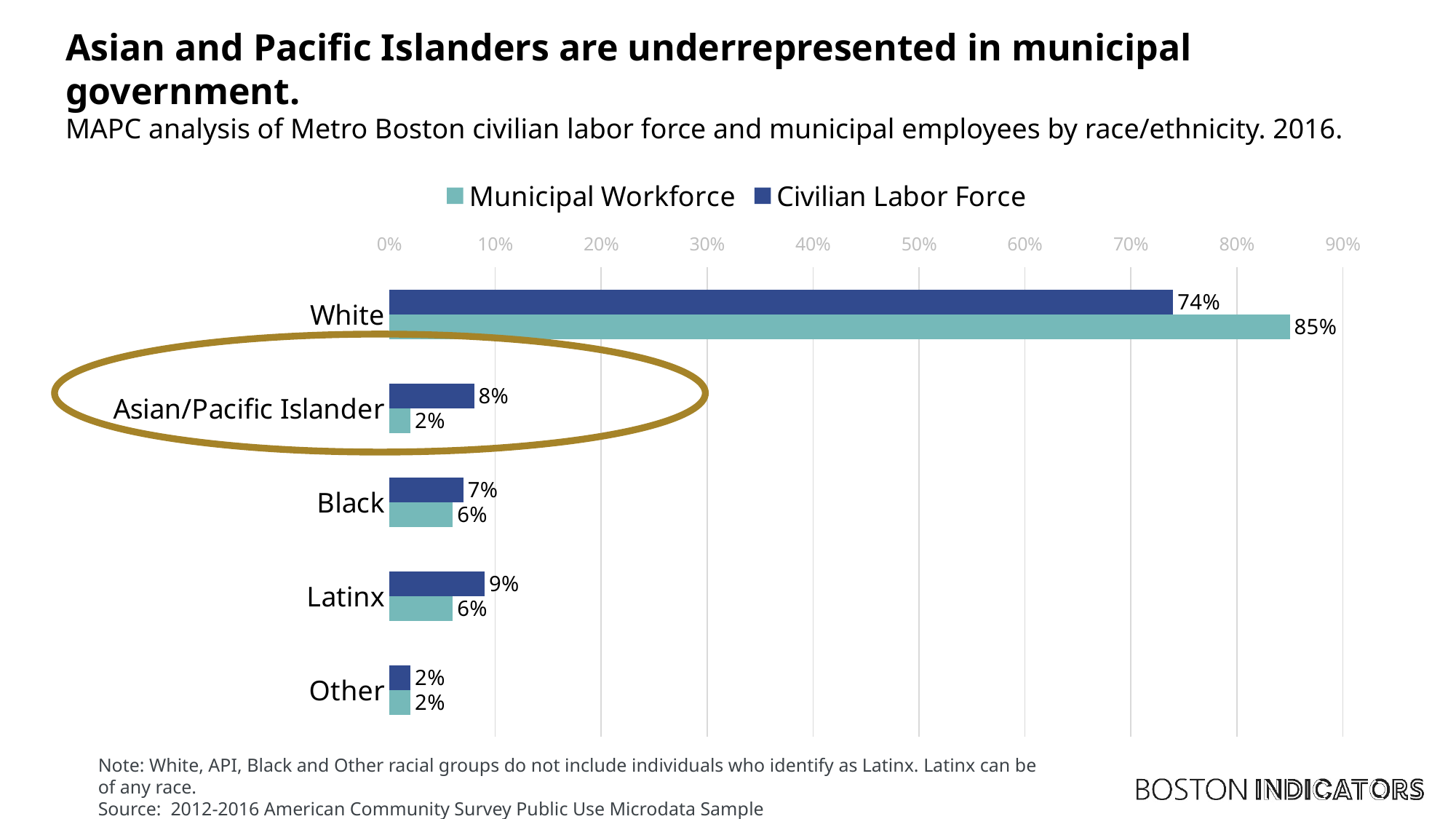
What is the Civilian Labor Force value for Black? 7% What is the Municipal Workforce value for White? 85% What is the difference between the Municipal Workforce and Civilian Labor Force values for White? 11% Which is larger for Latinx: the Civilian Labor Force value or the Municipal Workforce value? Civilian Labor Force What is the Civilian Labor Force value for Asian/Pacific Islander? 8% Which category has the lowest Civilian Labor Force value? Other What is the Municipal Workforce value for Latinx? 6% How many series does the legend list? 2 How many race/ethnicity categories are shown on the chart? 5 What is the difference between the Civilian Labor Force and Municipal Workforce values for Asian/Pacific Islander? 6% What kind of chart is shown on the slide? Bar chart Which category has the highest Municipal Workforce value? White